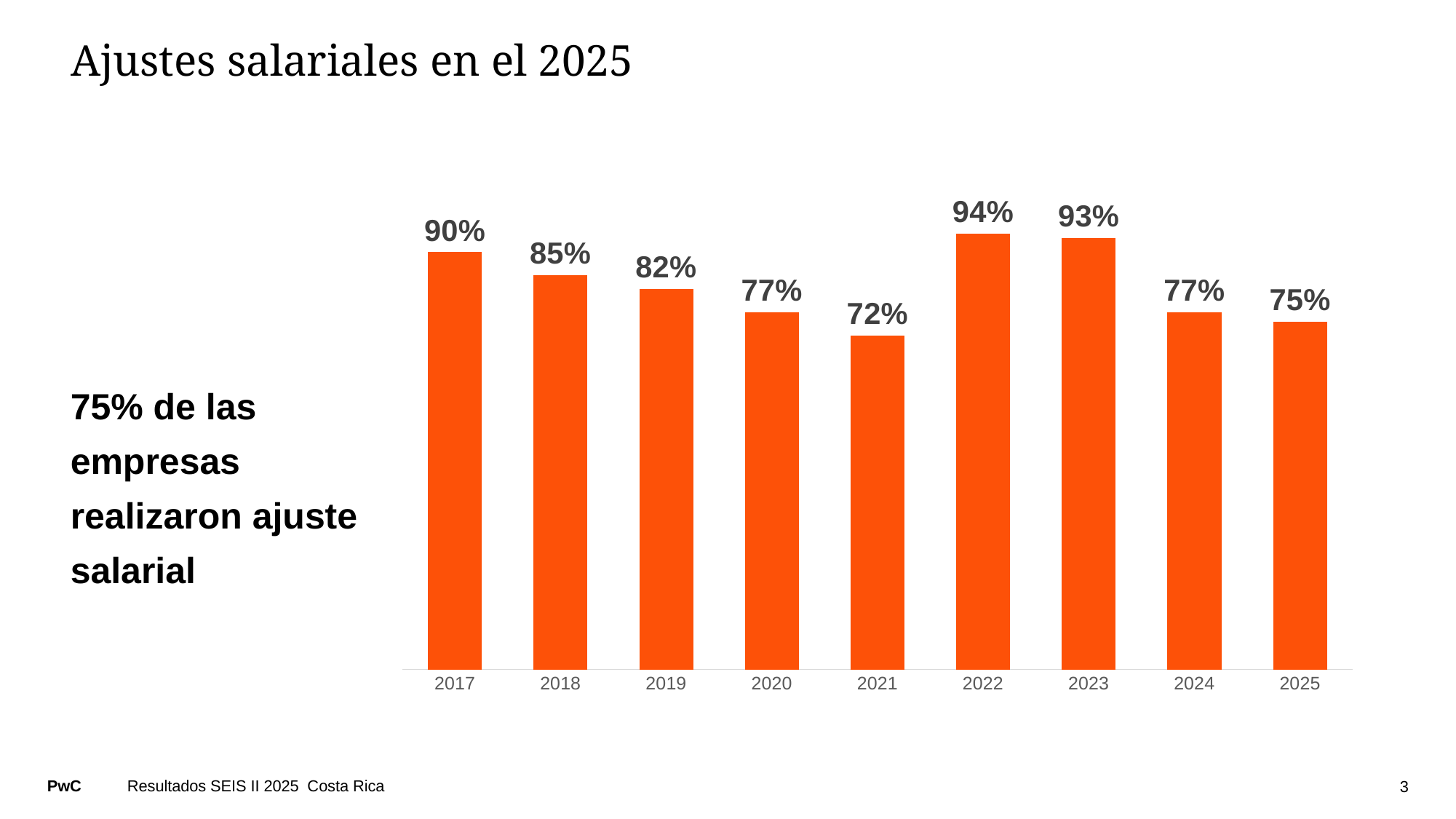
What kind of chart is shown on the slide? Bar chart Which year has the highest value? 2022 What is the value for 2017? 90% Which is larger, the value for 2019 or the value for 2024? 2019 What colour are the bars in the chart? Orange What is the value for 2025? 75% How many years are shown on the x axis? 9 What is the value for 2021? 72% What is the difference between the values for 2022 and 2025? 19% What is the difference between the values for 2017 and 2018? 5% Which year has the lowest value? 2021 Do the values rise or fall from 2017 to 2021? Fall